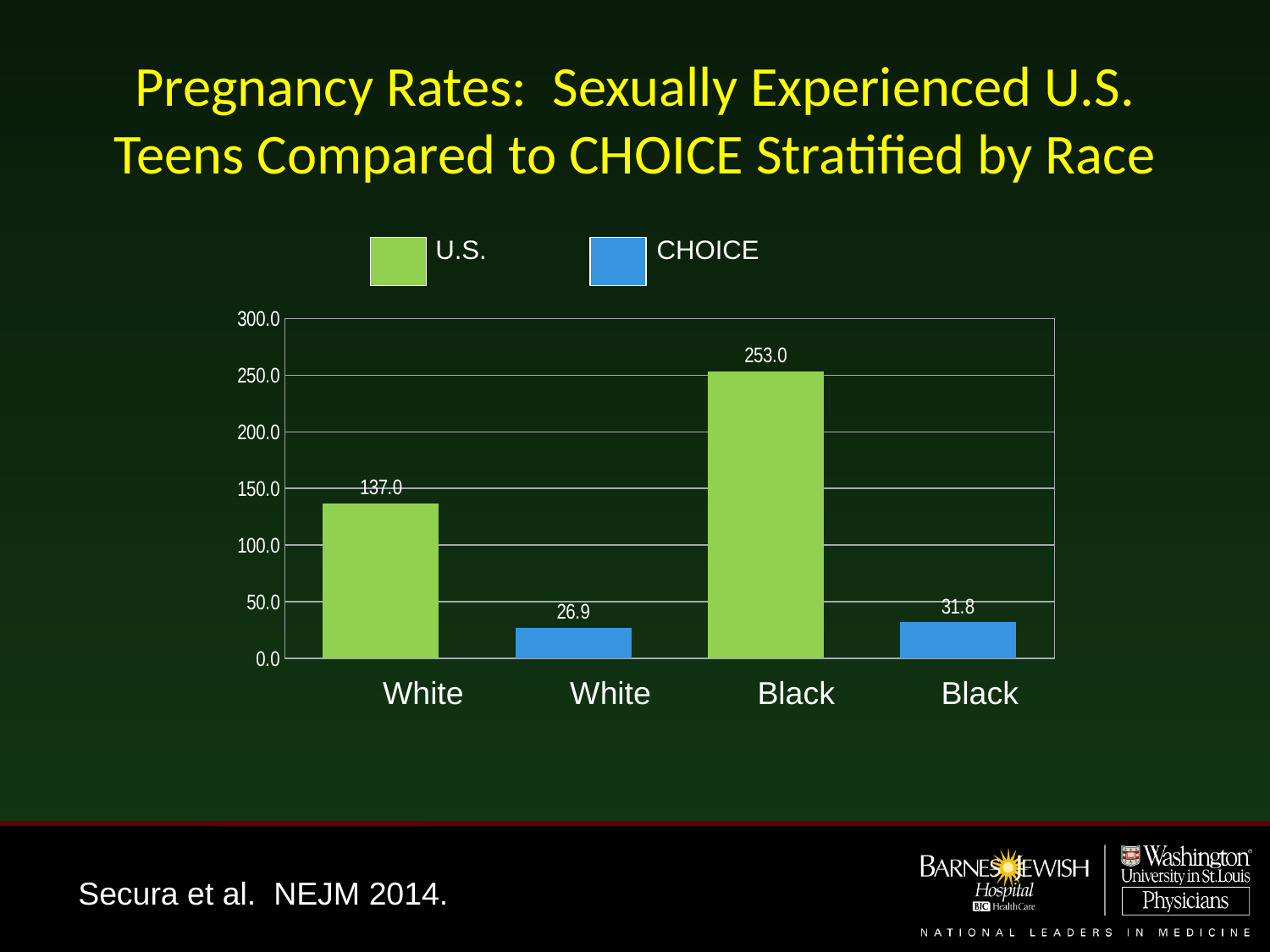
What is the difference between the U.S. rate for Black teens and the U.S. rate for White teens? 116.0 How many series does the legend list? 2 What is the difference between the U.S. rate and the CHOICE rate for White teens? 110.1 Is the U.S. rate for Black teens greater or less than 200.0? greater What is the U.S. pregnancy rate for White teens? 137.0 What is the CHOICE pregnancy rate for White teens? 26.9 How many bars are plotted in the chart? 4 Which bar has the lowest value? CHOICE White (26.9) What is the CHOICE pregnancy rate for Black teens? 31.8 Which bar has the highest value? U.S. Black (253.0) Which is larger, the CHOICE rate for Black teens or the CHOICE rate for White teens? CHOICE rate for Black teens What type of chart is shown on the slide? Bar chart